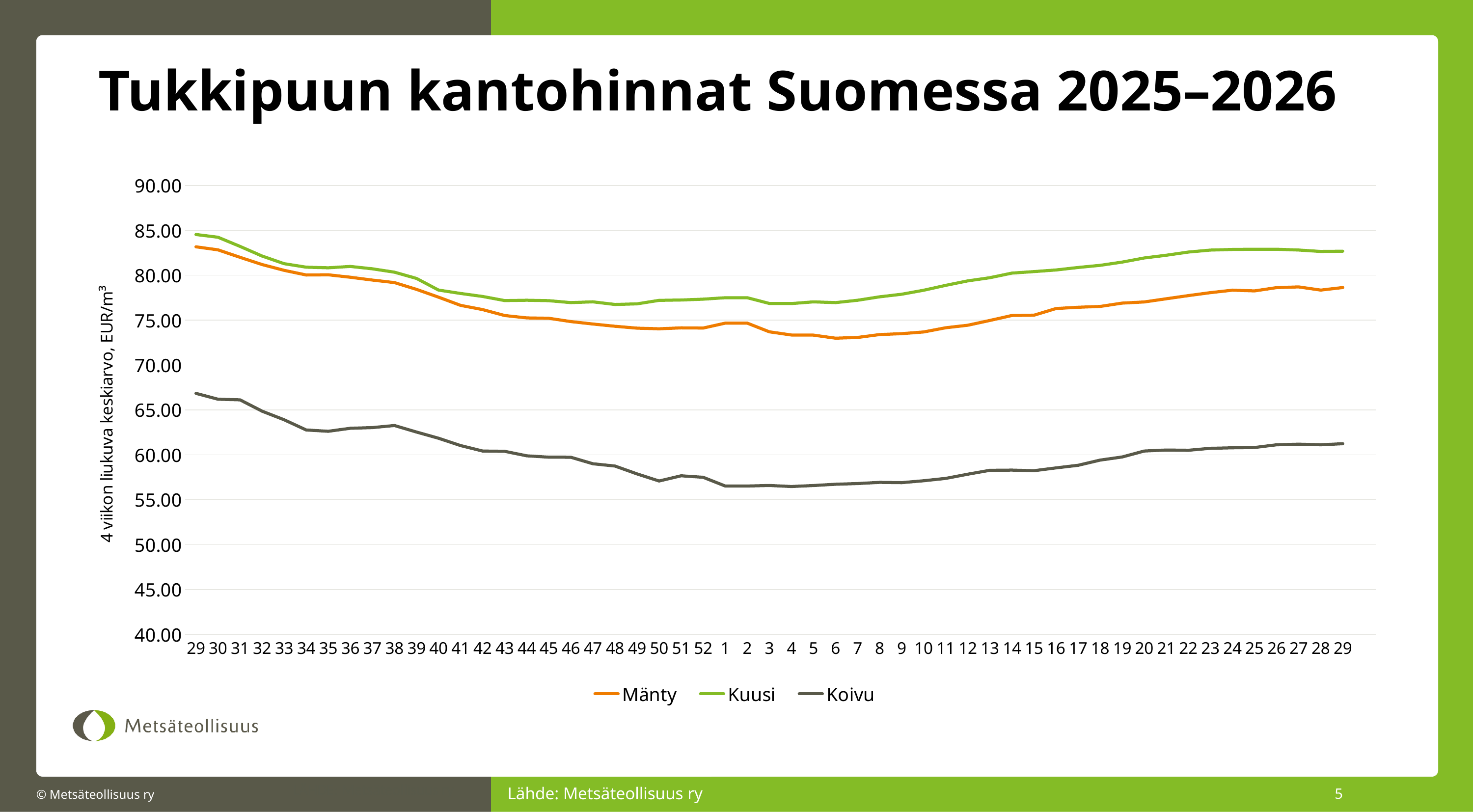
What kind of chart is shown on the slide? line chart Is the value for Kuusi at the first week 29 greater or less than 80.00? greater Is the value for Koivu at the first week 29 greater or less than 65.00? greater Is the value for Mänty at week 6 greater or less than 75.00? less What is the label of the vertical axis? 4 viikon liukuva keskiarvo, EUR/m³ Does the Kuusi line rise or fall from week 10 to week 24? rise Which series has the lowest values across the whole chart? Koivu At week 40, which is larger, the value for Kuusi or the value for Koivu? Kuusi Which series has the highest values across the whole chart? Kuusi How many series does the legend list? 3 Does the Koivu line rise or fall from week 29 to week 1? fall